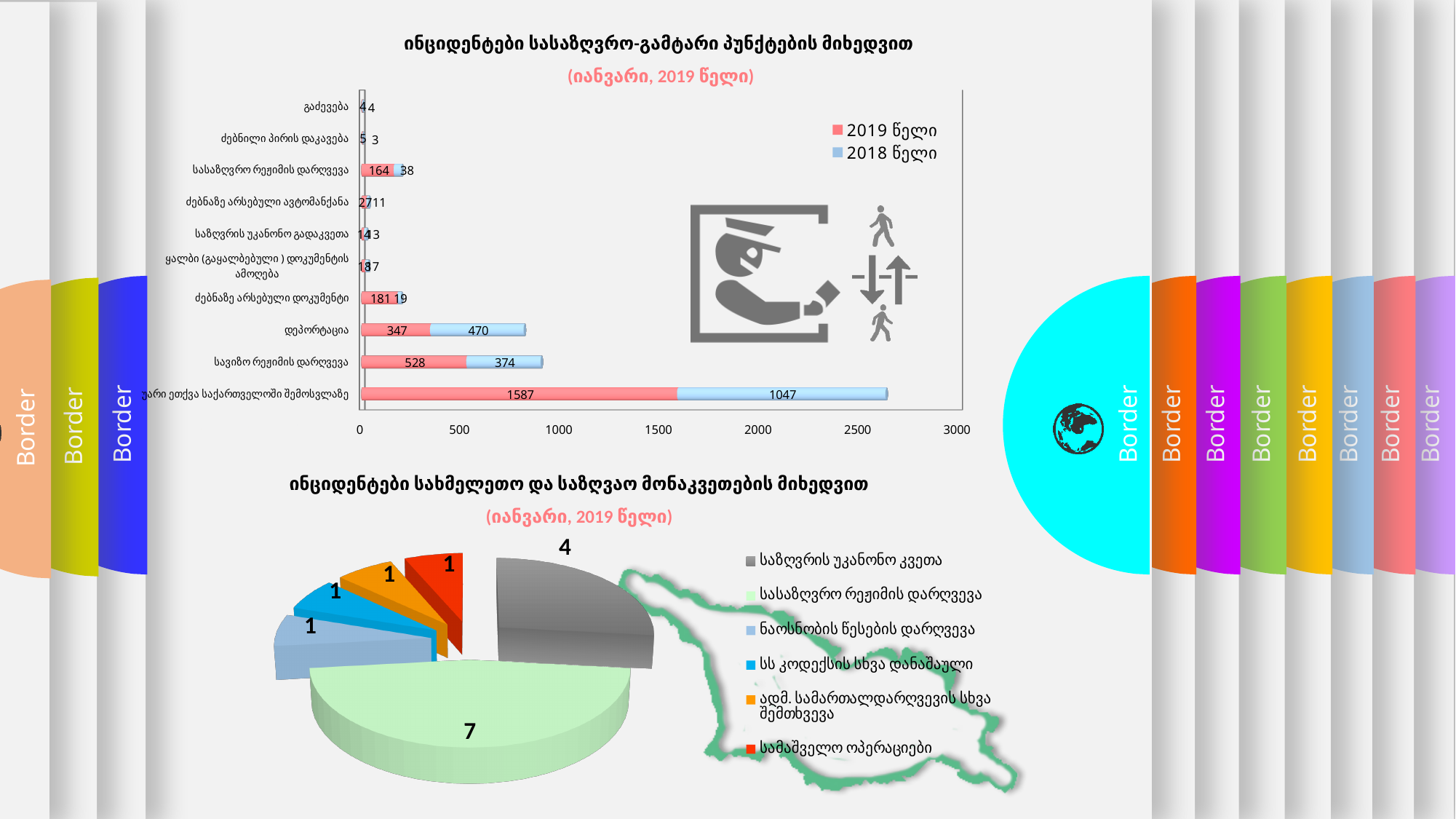
In the top bar chart, what is the 2019 value for უარი ეთქვა საქართველოში შემოსვლაზე? 1587 In the top bar chart, what is the difference between the 2019 and 2018 values for დეპორტაცია? 123 In the top bar chart, what is the 2019 value for დეპორტაცია? 347 What kind of chart is the bottom chart on the slide? Pie chart How many categories are shown in the top bar chart? 10 In the top bar chart, what is the total of the stacked bar for უარი ეთქვა საქართველოში შემოსვლაზე? 2634 How many series does the legend of the top bar chart list? 2 In the top bar chart, which is larger for სასაზღვრო რეჟიმის დარღვევა: the 2019 value or the 2018 value? 2019 value In the top bar chart, which category has the highest 2019 value? უარი ეთქვა საქართველოში შემოსვლაზე In the bottom pie chart, what is the value for სასაზღვრო რეჟიმის დარღვევა? 7 In the bottom pie chart, which category has the largest slice? სასაზღვრო რეჟიმის დარღვევა In the top bar chart, what is the 2018 value for სავიზო რეჟიმის დარღვევა? 374